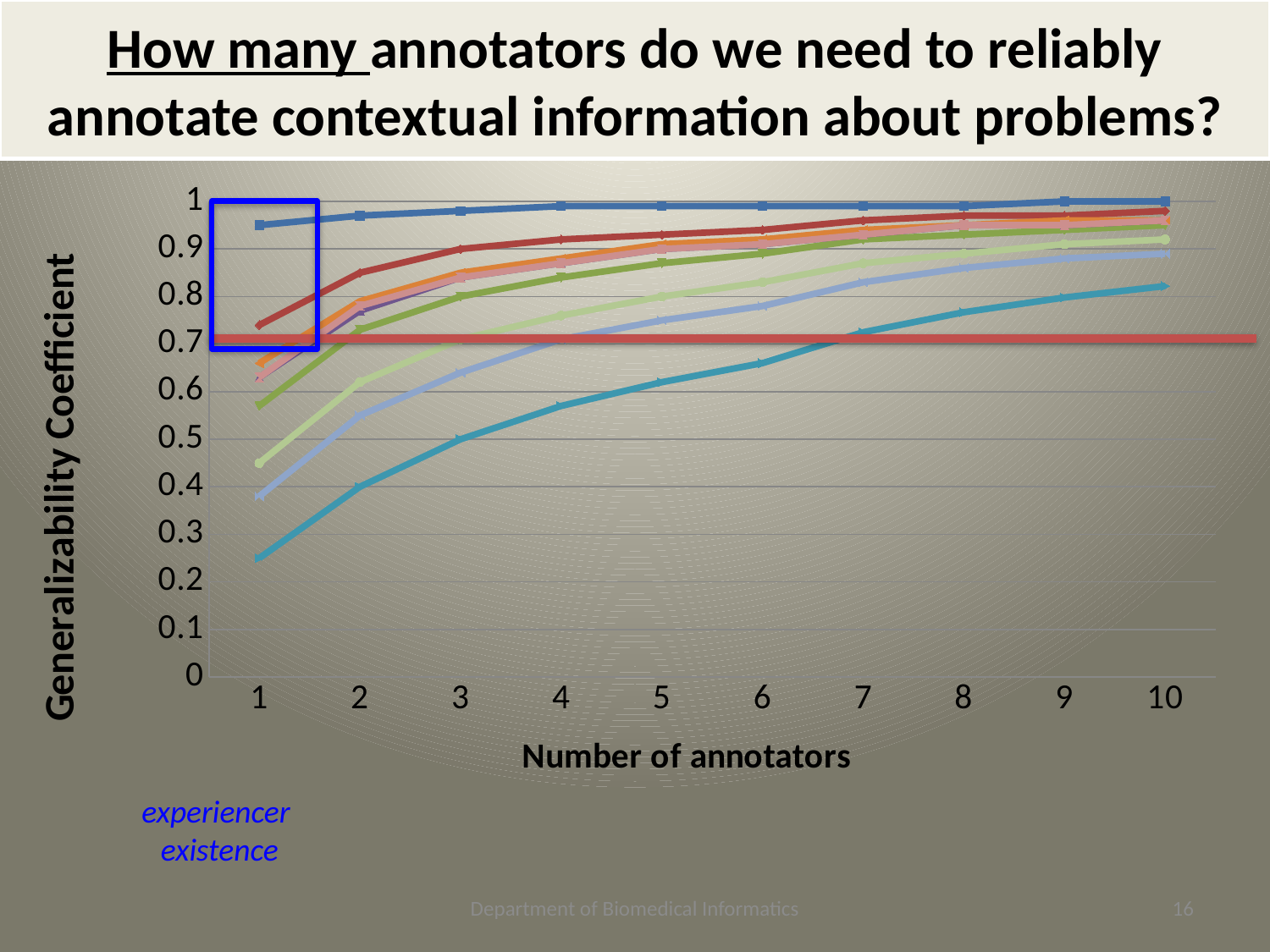
Is the value of the topmost line at 1 annotator greater or less than 0.9? greater Is the value of the lowest line at 5 annotators greater or less than 0.7? less At which number of annotators is the lowest line at its minimum? 1 Is the value of the lowest line at 1 annotator greater or less than 0.3? less What is the title of the y axis? Generalizability Coefficient Which is larger at 1 annotator: the value of the topmost line or the value of the lowest line? the topmost line What is the highest tick value shown on the y axis? 1 Do the plotted lines rise or fall as the number of annotators increases? rise What is the title of the x axis? Number of annotators What kind of chart is shown on the slide? line chart How many values of the number of annotators are plotted along the x axis? 10